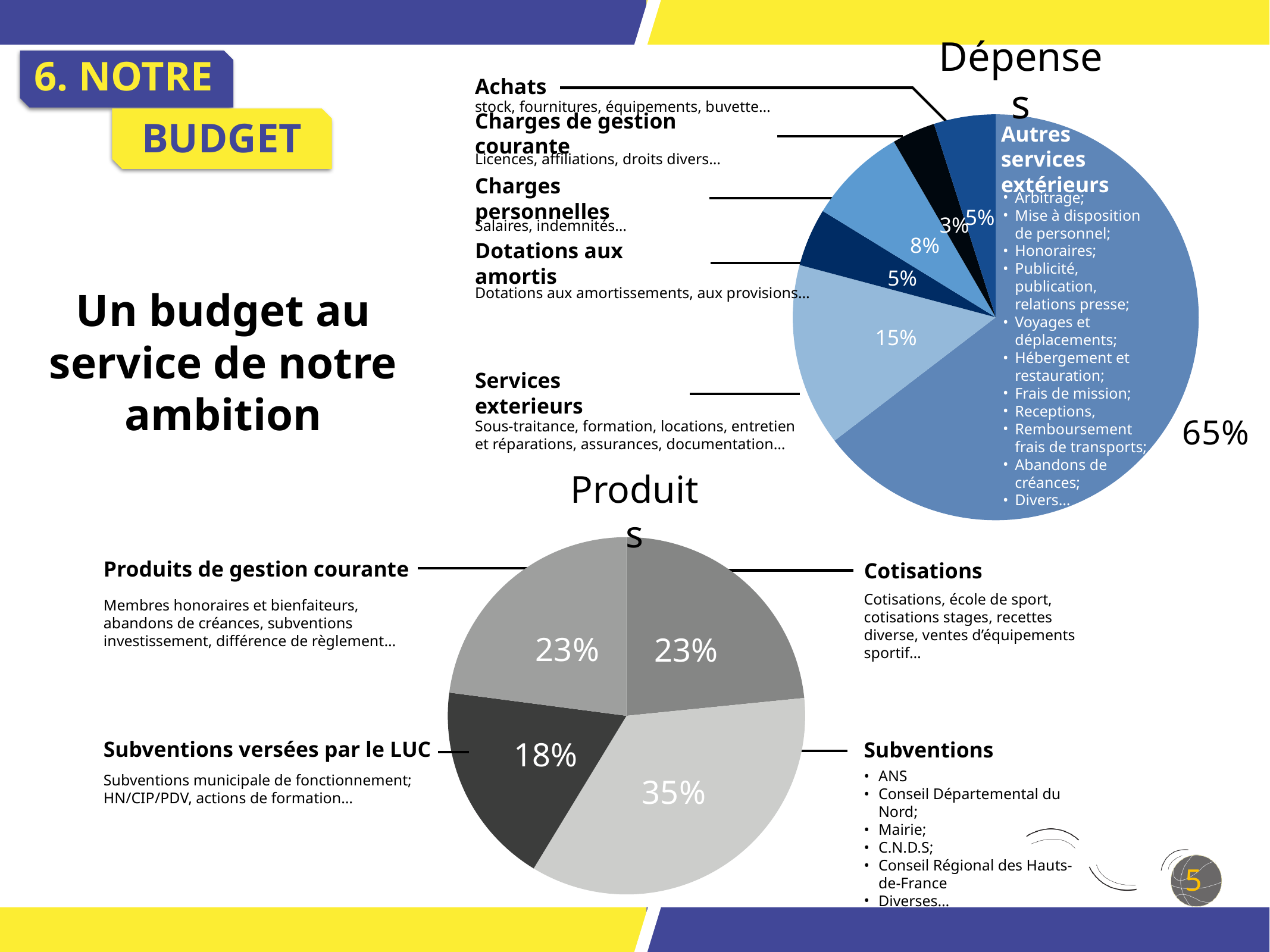
In the Dépenses pie chart, what share is labelled for Charges personnelles? 8% How many slices does the Produits pie chart have? 4 In the Dépenses pie chart, which category has the largest slice? Autres services extérieurs In the Dépenses pie chart, what share is labelled for Autres services extérieurs? 65% In the Produits pie chart, which category has the largest slice? Subventions In the Produits pie chart, what share is labelled for Subventions? 35% In the Dépenses pie chart, which category has the smallest slice? Charges de gestion courante What type of chart is the Dépenses chart? Pie chart In the Dépenses pie chart, what is the difference between the Autres services extérieurs share and the Services exterieurs share? 50% In the Dépenses pie chart, what share is labelled for Services exterieurs? 15%